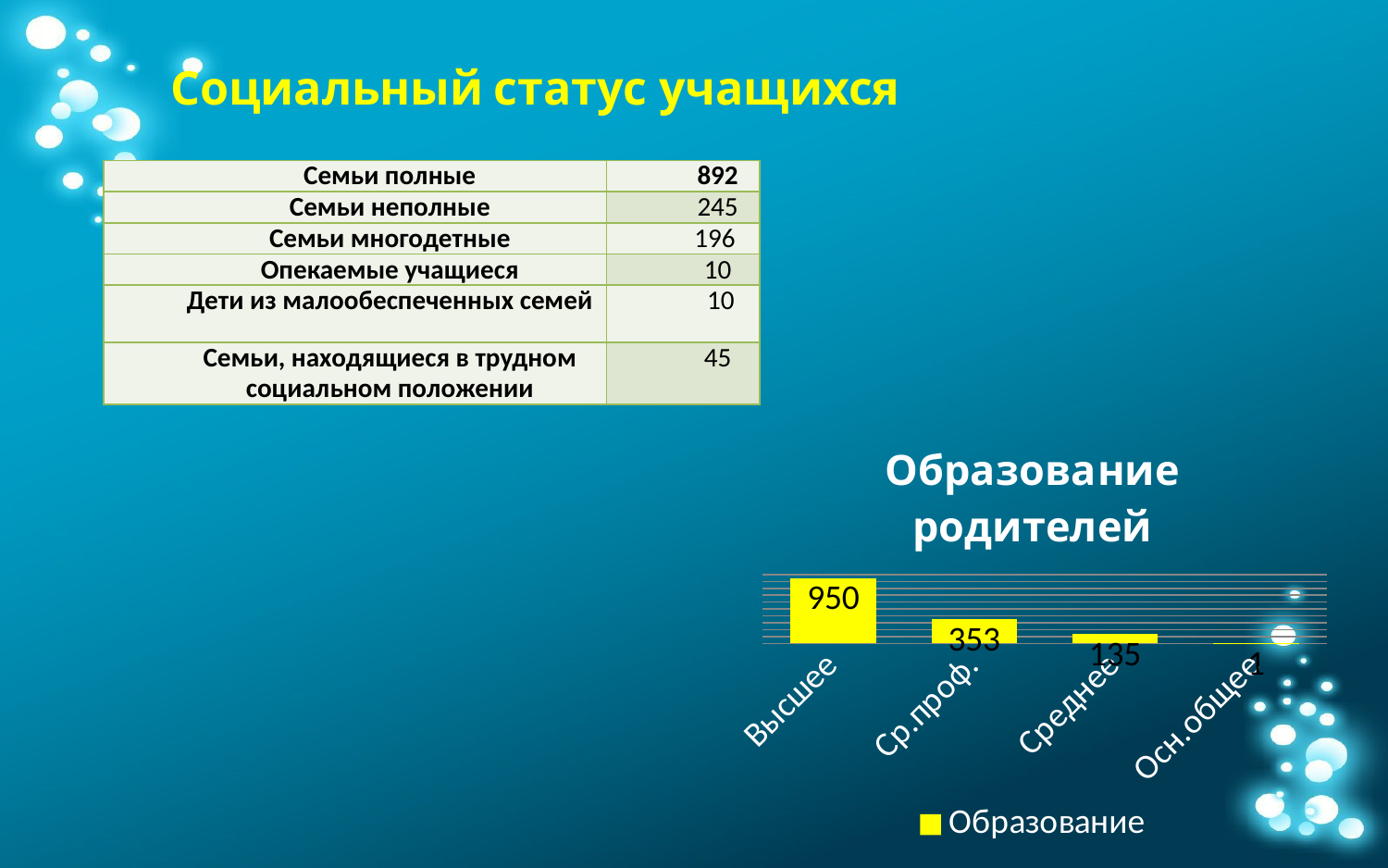
In the "Образование родителей" chart, what is the value for Ср.проф.? 353 How many series does the legend of the "Образование родителей" chart list? 1 In the "Образование родителей" chart, what is the value for Высшее? 950 In the "Образование родителей" chart, what is the difference between the values for Высшее and Ср.проф.? 597 What kind of chart is shown under the title "Образование родителей"? bar chart In the "Образование родителей" chart, which is larger: the value for Ср.проф. or the value for Среднее? Ср.проф. Do the values in the "Образование родителей" chart rise or fall from left to right along the x axis? fall In the "Образование родителей" chart, which category has the lowest value? Осн.общее In the "Образование родителей" chart, which category has the highest value? Высшее How many categories are shown in the "Образование родителей" chart? 4 In the "Образование родителей" chart, what is the difference between the values for Ср.проф. and Среднее? 218 In the "Образование родителей" chart, what is the value for Среднее? 135